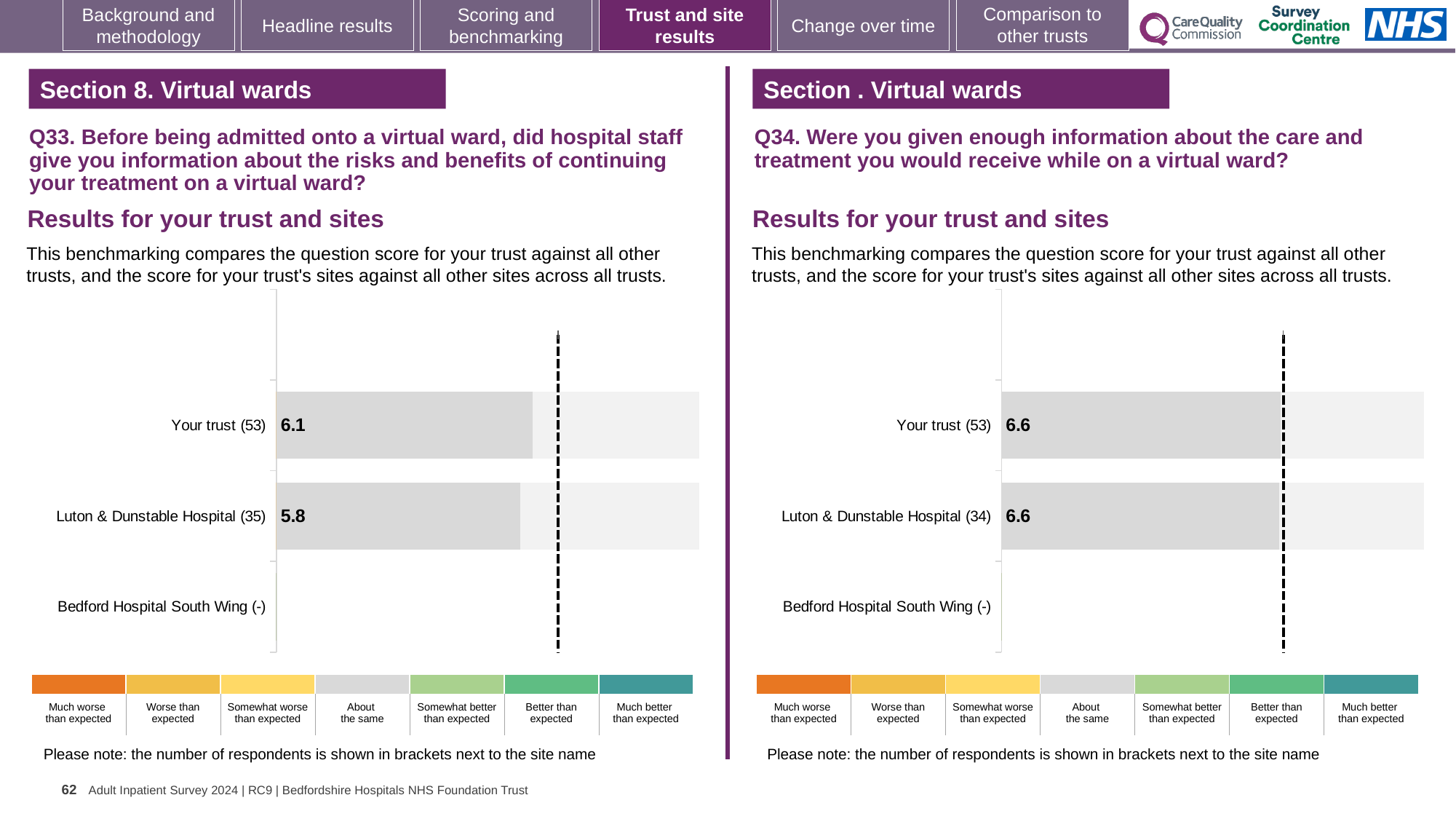
How many rows (categories) are listed in the left chart (Q33)? 3 In the left chart (Q33), which has the higher score, Your trust or Luton & Dunstable Hospital? Your trust In the left chart (Q33), what is the difference between the score for Your trust and the score for Luton & Dunstable Hospital? 0.3 In the left chart (Q33), what is the score for Your trust? 6.1 In the right chart (Q34), how many respondents are shown in brackets for Luton & Dunstable Hospital? 34 In the left chart (Q33), how many respondents are shown in brackets for Your trust? 53 In the right chart (Q34), what is the score for Your trust? 6.6 What kind of chart is used in the right chart (Q34)? Bar chart In the right chart (Q34), what is the score for Luton & Dunstable Hospital? 6.6 In the left chart (Q33), which row has the highest score shown? Your trust In the left chart (Q33), what is the score for Luton & Dunstable Hospital? 5.8